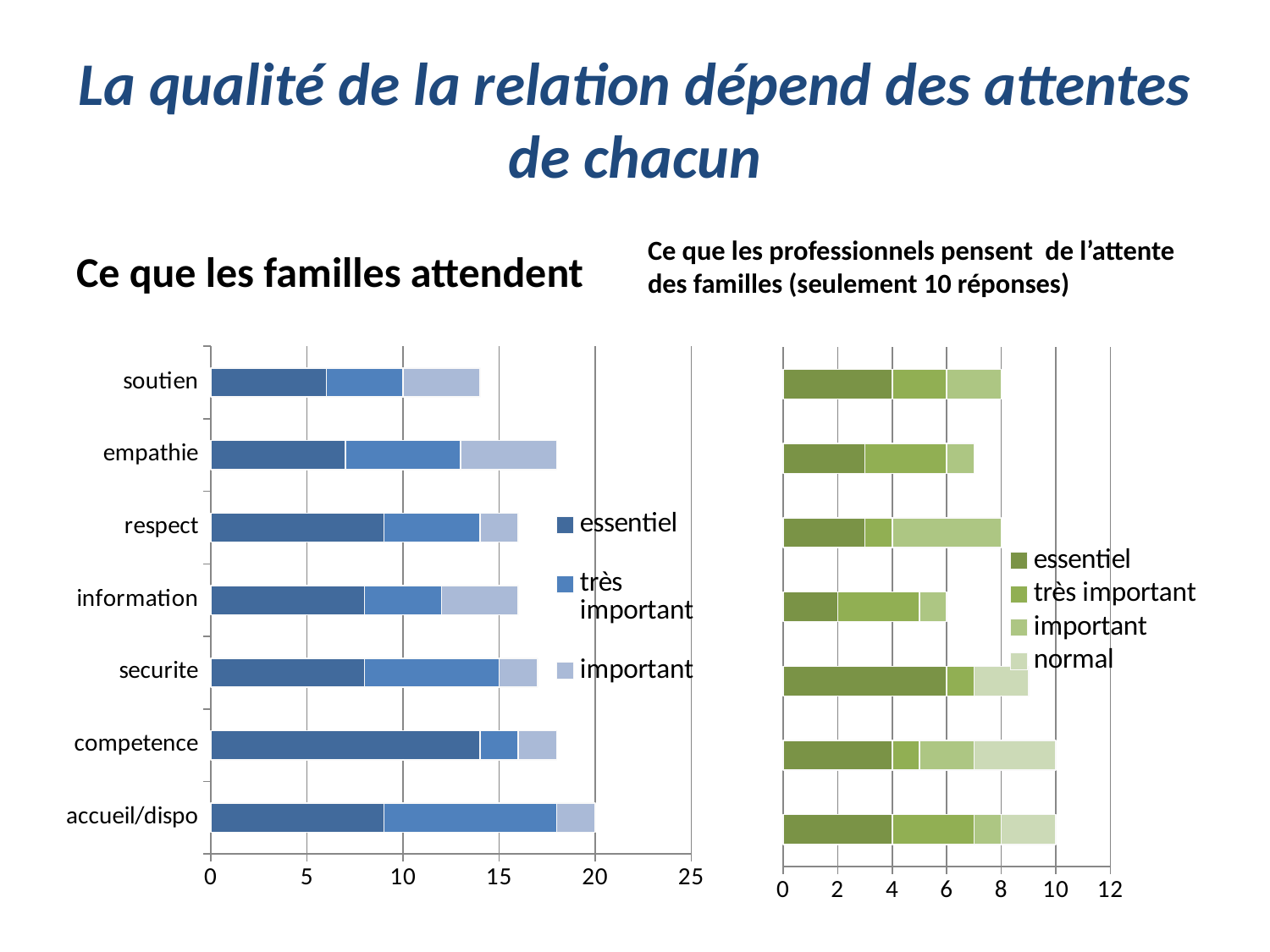
How many categories are shown on the 'Ce que les familles attendent' chart? 7 On the 'Ce que les familles attendent' chart, is the total for competence greater or less than 15? greater On the 'Ce que les familles attendent' chart, is the total for soutien greater or less than 15? less On the 'Ce que les familles attendent' chart, which category has the shortest total bar? soutien On the 'Ce que les familles attendent' chart, which category has the longest total bar? accueil/dispo What are the legend entries of the right-hand chart ('Ce que les professionnels pensent de l'attente des familles')? essentiel, très important, important, normal What kind of chart is the 'Ce que les familles attendent' chart? bar chart How many series does the legend of the 'Ce que les familles attendent' chart list? 3 On the 'Ce que les familles attendent' chart, which has the larger total bar, accueil/dispo or soutien? accueil/dispo How many series does the legend of the right-hand chart ('Ce que les professionnels pensent de l'attente des familles') list? 4 On the 'Ce que les familles attendent' chart, is the 'essentiel' segment for competence greater or less than 10? greater On the 'Ce que les familles attendent' chart, what is the total length of the accueil/dispo bar? 20